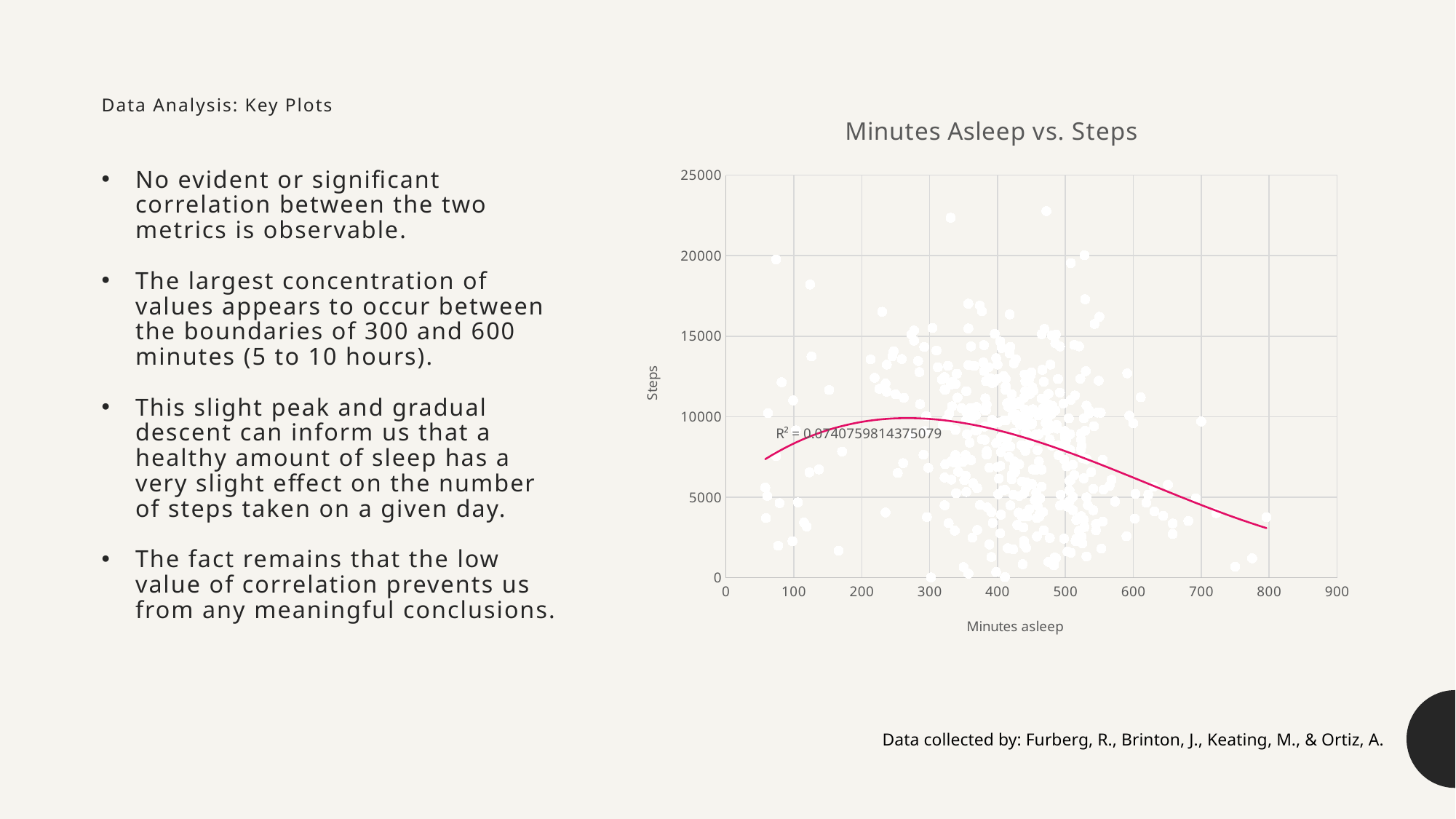
What is the highest value shown on the x axis of the chart? 900 Is the value of the trendline at 600 minutes asleep greater or less than 10000 steps? less What is the title of the chart? Minutes Asleep vs. Steps Is the value of the trendline at 100 minutes asleep greater or less than 5000 steps? greater What R² value is printed on the chart? R² = 0.0740759814375079 Does the fitted trendline rise or fall between 100 and 250 minutes asleep? rise Does the fitted trendline rise or fall between 500 and 800 minutes asleep? fall Is the value of the trendline at 800 minutes asleep greater or less than 5000 steps? less What kind of chart is shown on the slide? scatter plot What is the label of the x axis of the chart? Minutes asleep What is the highest value shown on the y axis of the chart? 25000 What is the interval between consecutive tick marks on the y axis of the chart? 5000